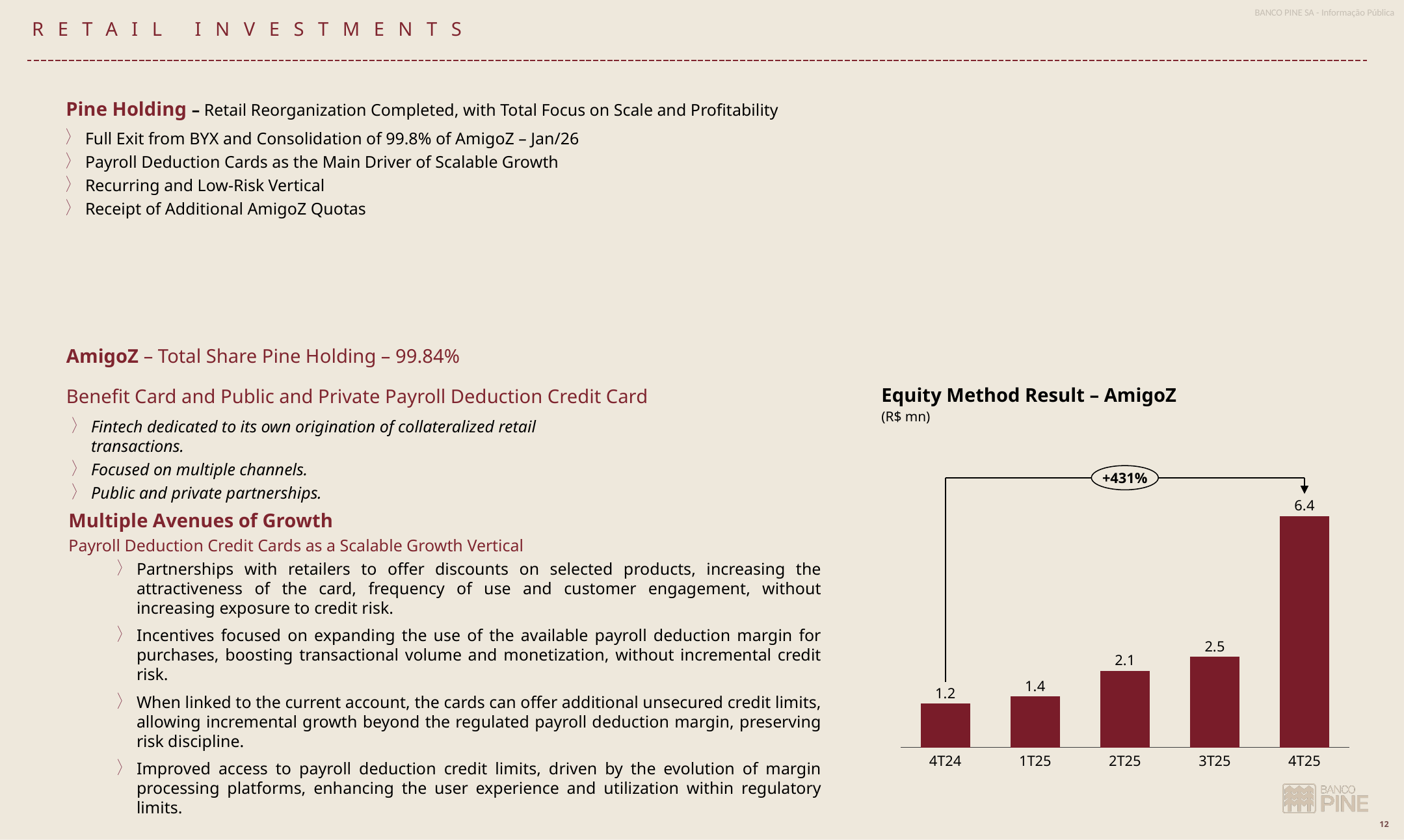
Which quarter has the lowest Equity Method Result for AmigoZ? 4T24 What is the Equity Method Result for AmigoZ in 4T25? 6.4 What kind of chart is the Equity Method Result – AmigoZ chart? Bar chart Which quarter has the highest Equity Method Result for AmigoZ? 4T25 What is the Equity Method Result for AmigoZ in 4T24? 1.2 What percentage growth is annotated between 4T24 and 4T25 in the Equity Method Result – AmigoZ chart? +431% How many quarters are shown in the Equity Method Result – AmigoZ chart? 5 What is the Equity Method Result for AmigoZ in 2T25? 2.1 Do the values in the Equity Method Result – AmigoZ chart rise or fall from 4T24 to 4T25? Rise What is the difference between the Equity Method Result in 4T25 and 3T25? 3.9 Which is larger, the Equity Method Result in 3T25 or in 2T25? 3T25 What is the difference between the Equity Method Result in 1T25 and 4T24? 0.2